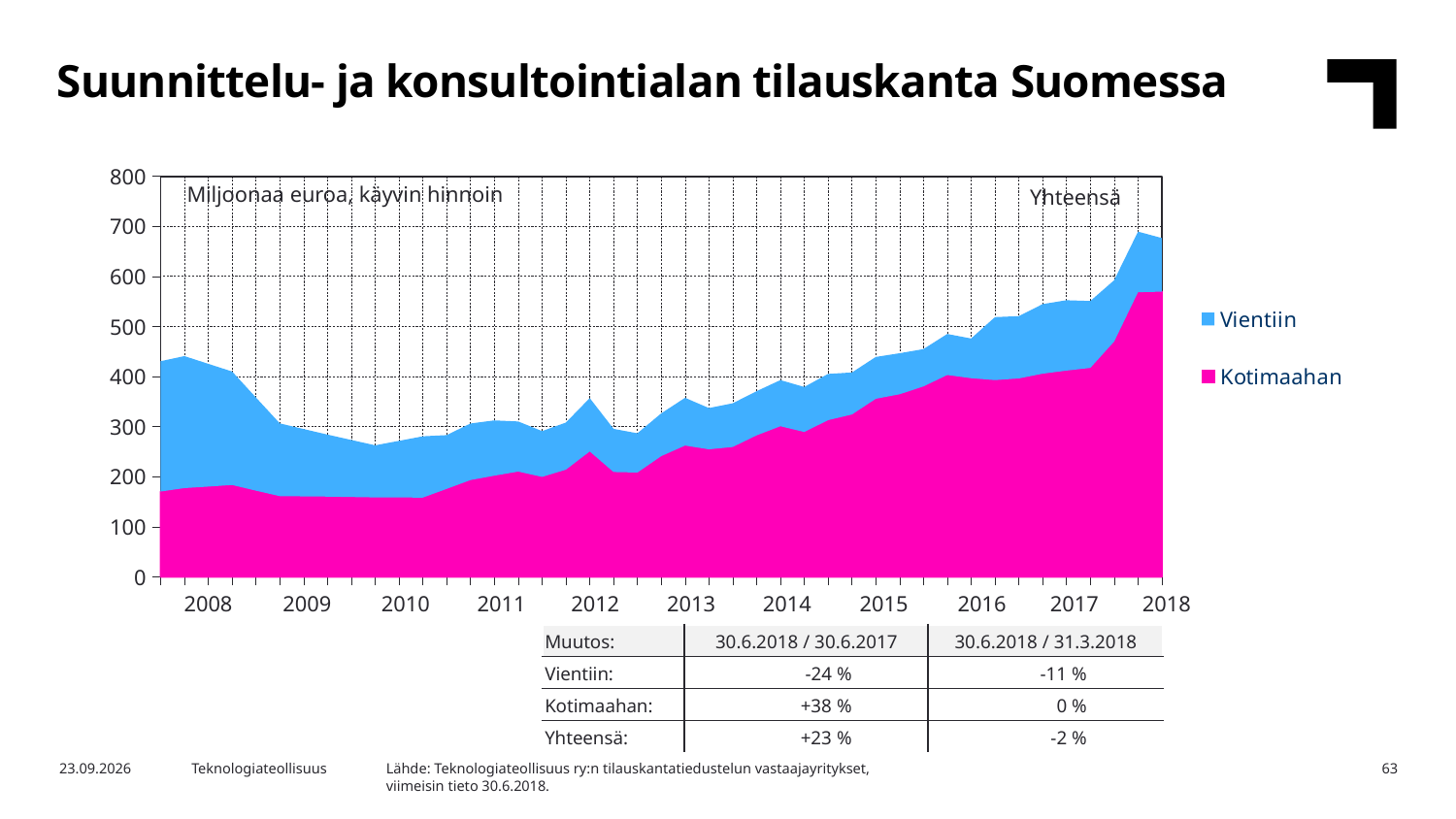
Is the total (Yhteensä) value at the end of the series in 2018 greater or less than 600? greater Is the Kotimaahan value at the start of 2008 greater or less than 200? less Does the Kotimaahan series rise or fall from 2010 to 2018? rise How many series does the legend list? 2 Is the total (Yhteensä) value in 2010 greater or less than 300? less What are the two series named in the legend? Vientiin and Kotimaahan What unit is stated in the chart's label at the top left? Miljoonaa euroa, käyvin hinnoin Is the total (Yhteensä) value larger in 2008 or in 2018? 2018 In which year does the total (Yhteensä) reach its highest point? 2018 What kind of chart is shown on the slide? Stacked area chart According to the table below the chart, what is the change for Vientiin between 30.6.2017 and 30.6.2018? -24 %